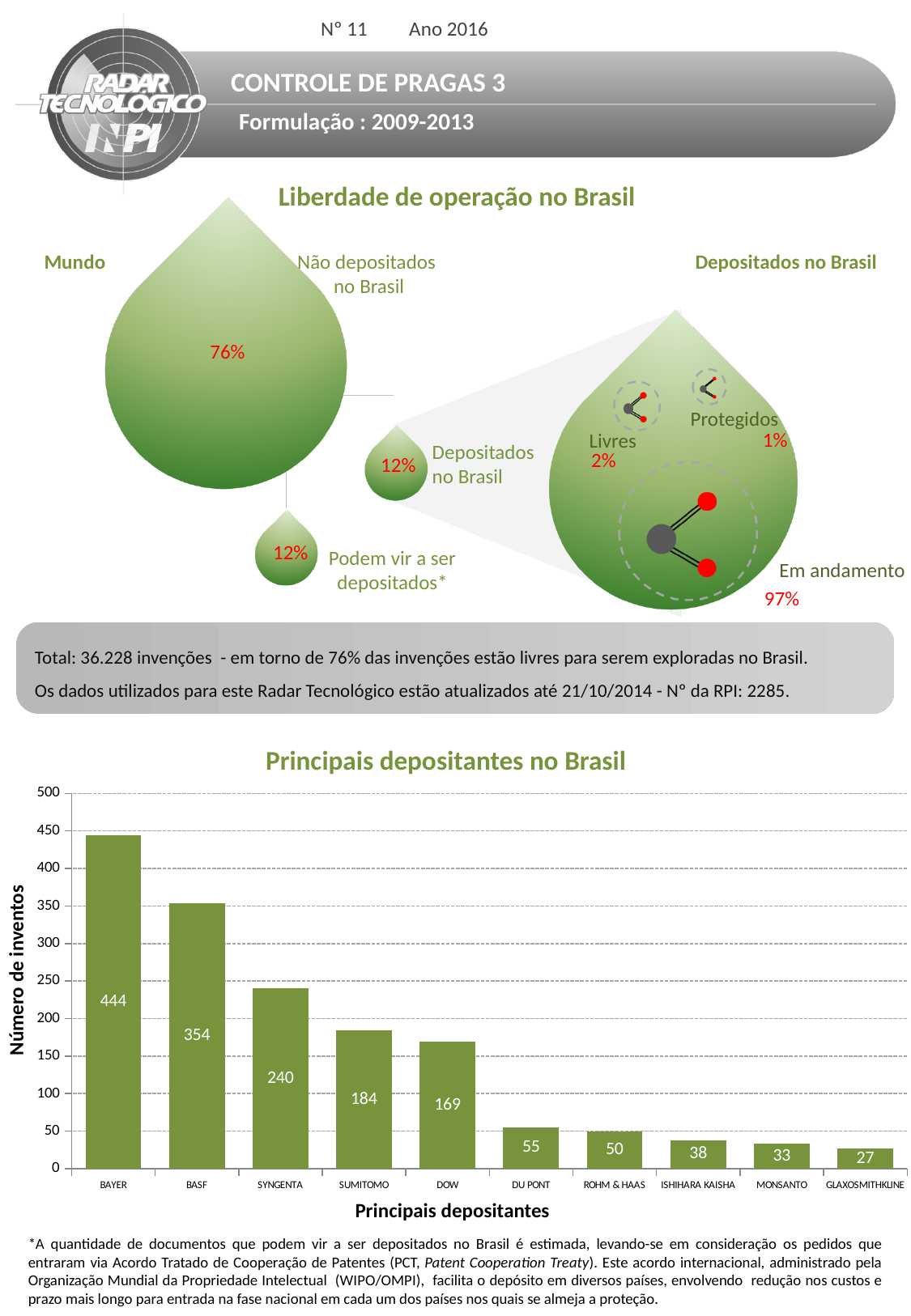
What is the y-axis label of the chart 'Principais depositantes no Brasil'? Número de inventos In the chart 'Principais depositantes no Brasil', what is the value for SUMITOMO? 184 In the chart 'Principais depositantes no Brasil', which is larger, the value for SYNGENTA or the value for DOW? SYNGENTA In the chart 'Principais depositantes no Brasil', is the value for BASF greater or less than 300? greater In the chart 'Principais depositantes no Brasil', which depositor has the lowest number of inventions? GLAXOSMITHKLINE What kind of chart is 'Principais depositantes no Brasil'? bar chart In the chart 'Principais depositantes no Brasil', which depositor has the highest number of inventions? BAYER In the chart 'Principais depositantes no Brasil', what is the difference between the values for BAYER and BASF? 90 In the chart 'Principais depositantes no Brasil', what is the value for MONSANTO? 33 In the chart 'Principais depositantes no Brasil', what is the difference between the values for DU PONT and ROHM & HAAS? 5 In the chart 'Principais depositantes no Brasil', what is the value for BAYER? 444 How many depositors are shown in the chart 'Principais depositantes no Brasil'? 10